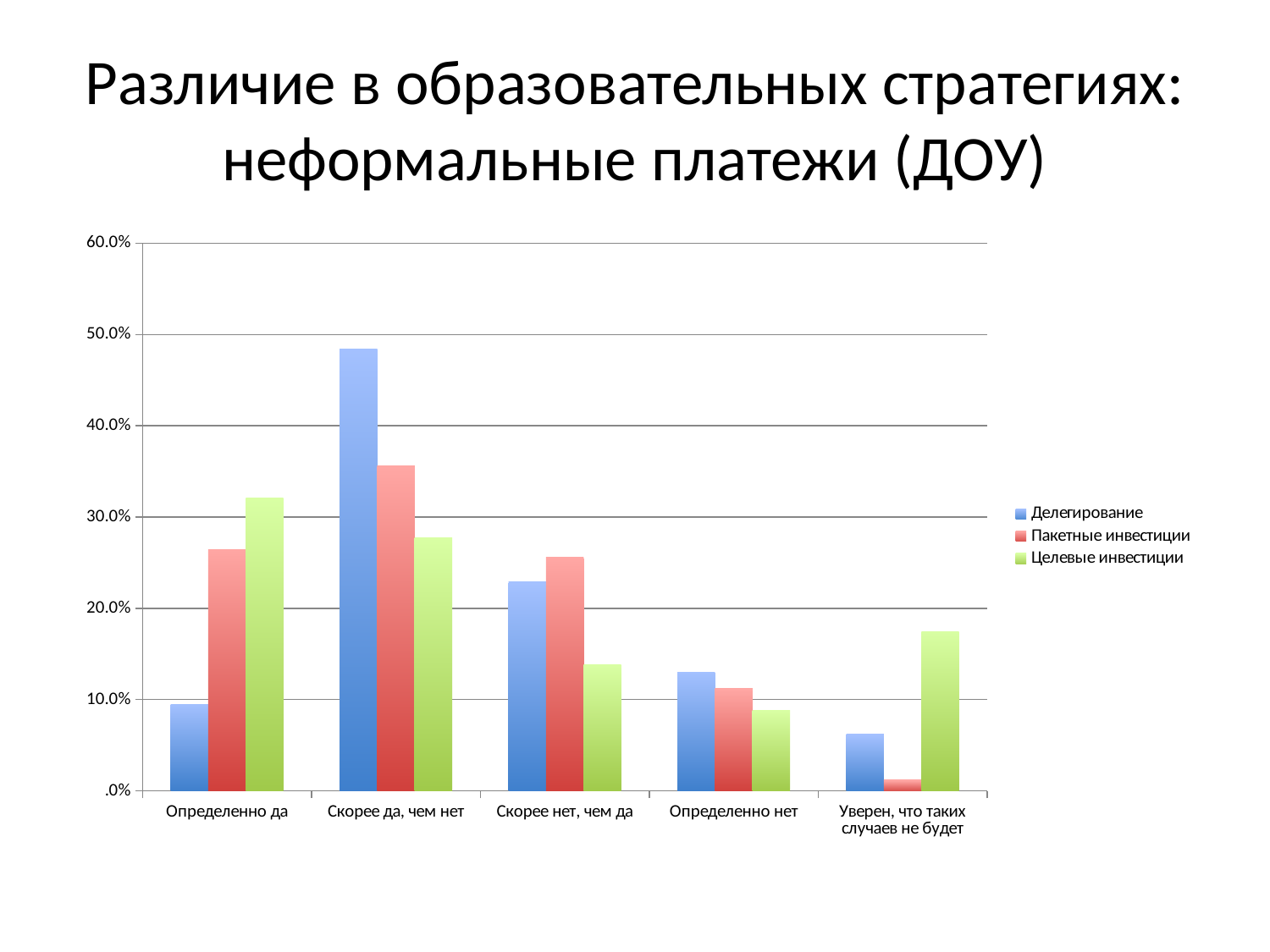
Which category has the lowest value for Пакетные инвестиции? Уверен, что таких случаев не будет Which category has the highest value for Целевые инвестиции? Определенно да In the category Уверен, что таких случаев не будет, which is larger: Целевые инвестиции or Делегирование? Целевые инвестиции Is the value for Пакетные инвестиции in the category Определенно да greater or less than 20.0%? greater In the category Определенно да, which is larger: Делегирование or Пакетные инвестиции? Пакетные инвестиции What kind of chart is shown on the slide? bar chart How many series does the legend list? 3 How many categories are shown on the x axis? 5 Is the value for Целевые инвестиции in the category Определенно нет greater or less than 10.0%? less What colour represents the series Целевые инвестиции in the legend? green Is the value for Делегирование in the category Скорее да, чем нет greater or less than 40.0%? greater Which category has the highest value for Делегирование? Скорее да, чем нет